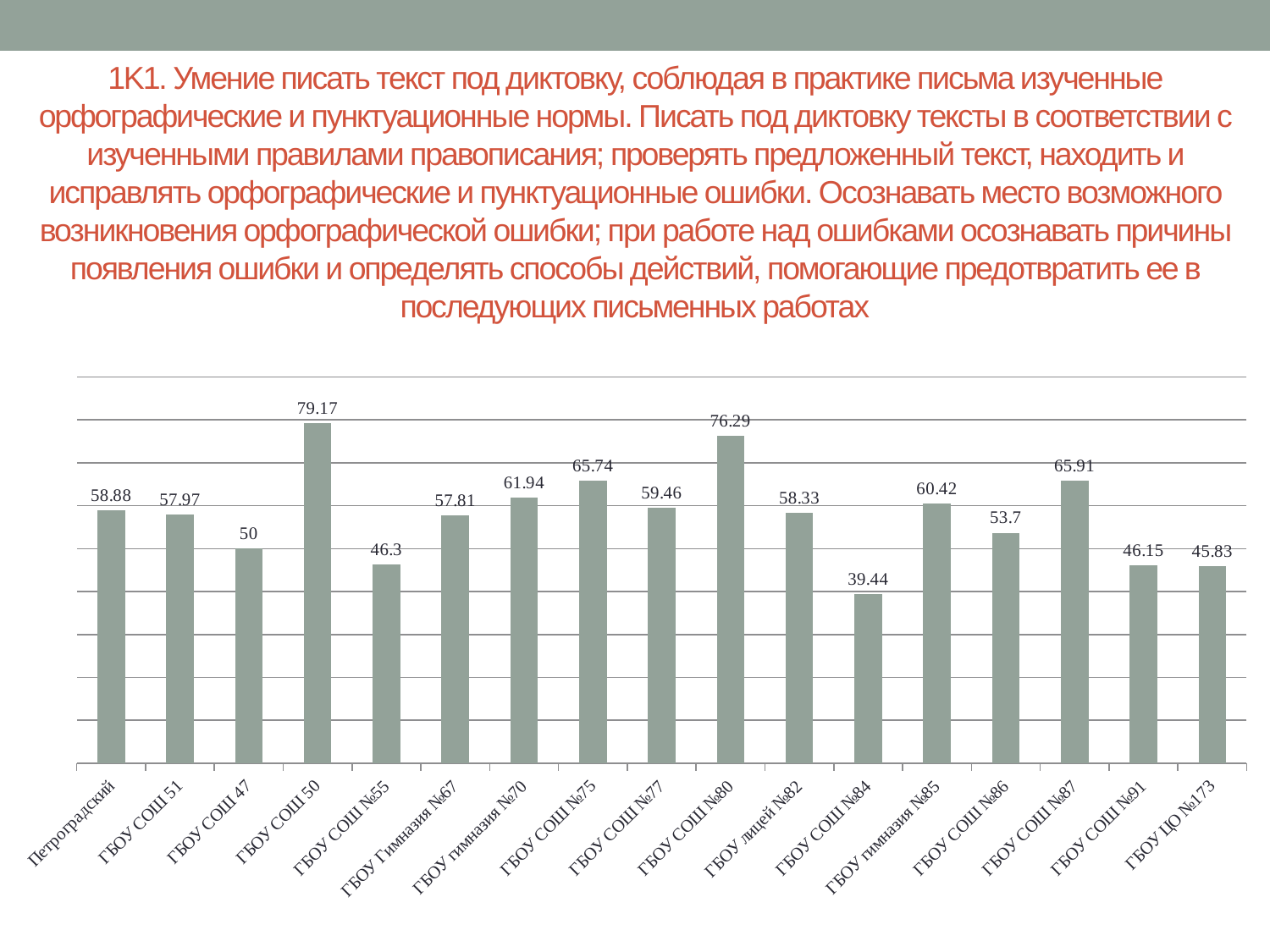
What is the value for ГБОУ ЦО №173? 45.83 Which category has the lowest value? ГБОУ СОШ №84 What is the value for Петроградский? 58.88 How many categories are shown on the x axis? 17 Which category has the highest value? ГБОУ СОШ 50 What is the value for ГБОУ СОШ №84? 39.44 What kind of chart is shown on the slide? bar chart What is the value for ГБОУ гимназия №85? 60.42 What is the difference between the values for ГБОУ СОШ №80 and Петроградский? 17.41 Which has a larger value, ГБОУ СОШ №80 or ГБОУ СОШ №75? ГБОУ СОШ №80 What is the difference between the values for ГБОУ СОШ 50 and ГБОУ СОШ №84? 39.73 What is the value for ГБОУ СОШ 50? 79.17